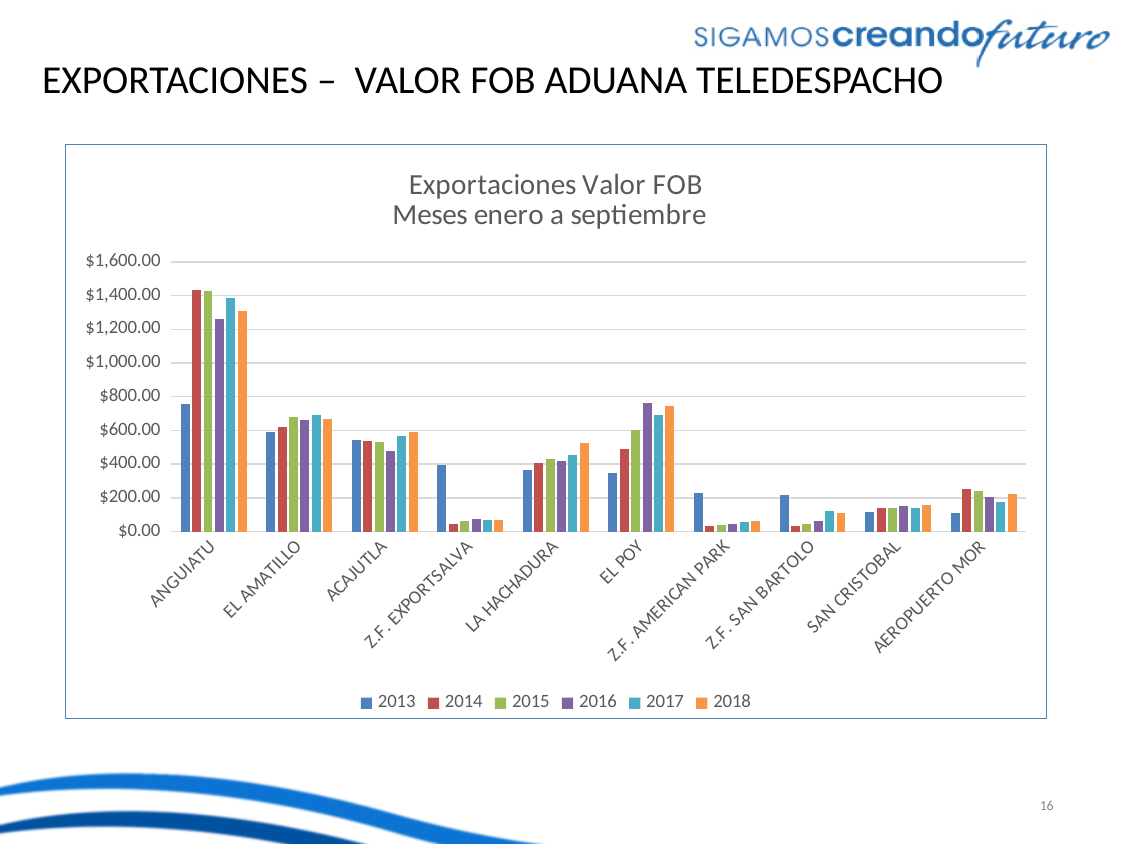
How many series does the legend list? 6 For EL POY, do the values rise or fall from 2013 to 2016? rise Is the 2013 value for ANGUIATU greater or less than $600.00? greater What kind of chart is shown on the slide? Bar chart For Z.F. EXPORTSALVA, which is larger: the 2013 value or the 2014 value? 2013 Is the 2018 value for SAN CRISTOBAL greater or less than $200.00? less Is the 2016 value for ANGUIATU greater or less than $1,000.00? greater Which customs office has the highest export values across all years? ANGUIATU How many customs offices (categories) are shown on the x axis? 10 For ANGUIATU, which is larger: the 2013 value or the 2014 value? 2014